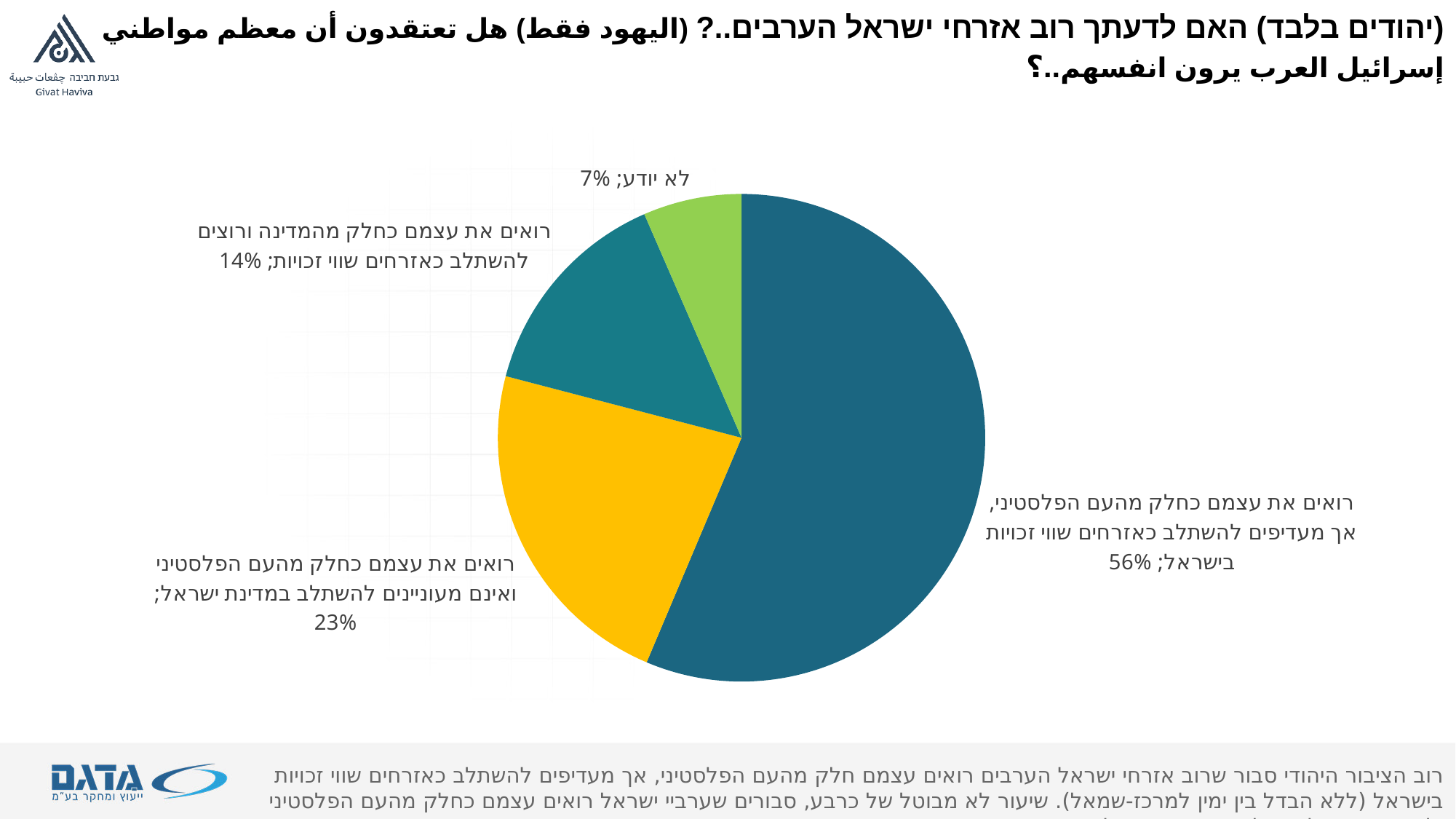
Which is larger: the slice for "רואים את עצמם כחלק מהמדינה ורוצים להשתלב כאזרחים שווי זכויות" or the slice for "לא יודע"? רואים את עצמם כחלק מהמדינה ורוצים להשתלב כאזרחים שווי זכויות What is the difference in percentage points between the 56% slice and the 23% slice? 33 What colour is the slice representing 23%? yellow/orange What percentage is shown for the slice labelled "לא יודע" (don't know)? 7% What percentage is shown for the slice labelled "רואים את עצמם כחלק מהעם הפלסטיני ואינם מעוניינים להשתלב במדינת ישראל"? 23% Which slice of the pie chart is the smallest? לא יודע (7%) How many slices does the pie chart have? 4 What percentage is shown for the slice labelled "רואים את עצמם כחלק מהמדינה ורוצים להשתלב כאזרחים שווי זכויות"? 14% What colour is the slice representing "לא יודע" (7%)? light green What kind of chart is shown on the slide? pie chart What percentage is shown for the slice labelled "רואים את עצמם כחלק מהעם הפלסטיני, אך מעדיפים להשתלב כאזרחים שווי זכויות בישראל"? 56% Which slice of the pie chart is the largest? רואים את עצמם כחלק מהעם הפלסטיני, אך מעדיפים להשתלב כאזרחים שווי זכויות בישראל (56%)